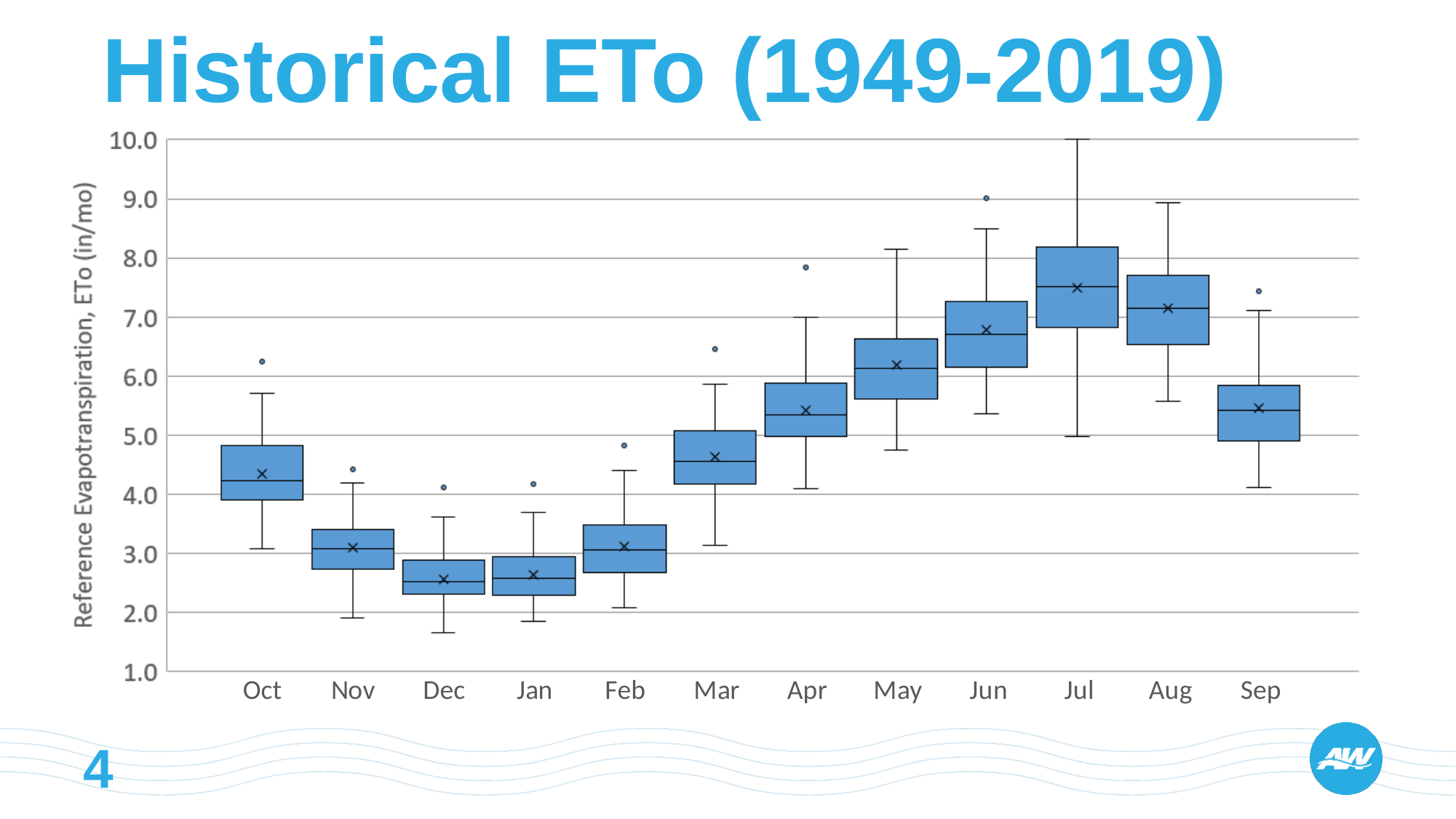
Which month's box has the highest upper whisker? Jul How many months (categories) are plotted on the x axis? 12 What is the label of the y axis? Reference Evapotranspiration, ETo (in/mo) Do the median ETo values rise or fall from Jan to Jul along the x axis? rise Is the median value for Jul greater or less than 7.0? greater Which month has the highest median ETo? Jul Is the median value for Jun greater or less than 7.0? less Which has the larger median ETo, Jul or Jan? Jul Is the median value for Dec greater or less than 3.0? less What is the title of the chart on the slide? Historical ETo (1949-2019) What kind of chart is shown on the slide? Box-and-whisker (box plot) chart